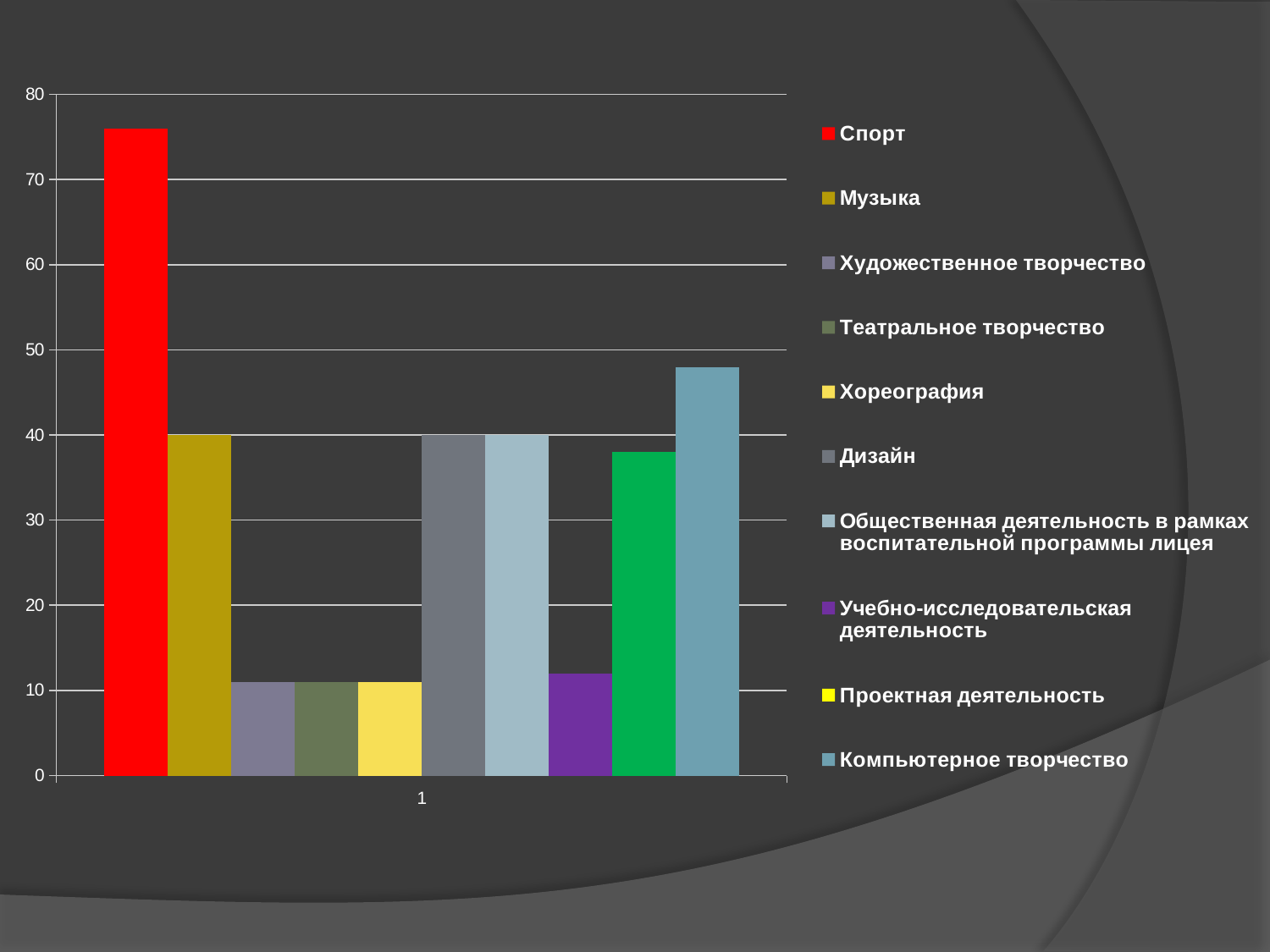
What is the value for Дизайн? 40 Is the value for Компьютерное творчество greater or less than 50? less Which series has the highest bar? Спорт Which is larger, the value for Спорт or the value for Музыка? Спорт Is the value for Спорт greater or less than 70? greater Is the value for Проектная деятельность greater or less than 40? less What is the value for Музыка? 40 What colour is the bar for Спорт? red Which is larger, the value for Компьютерное творчество or the value for Проектная деятельность? Компьютерное творчество What kind of chart is shown on the slide? bar chart How many series does the legend list? 10 What is the value for Общественная деятельность в рамках воспитательной программы лицея? 40